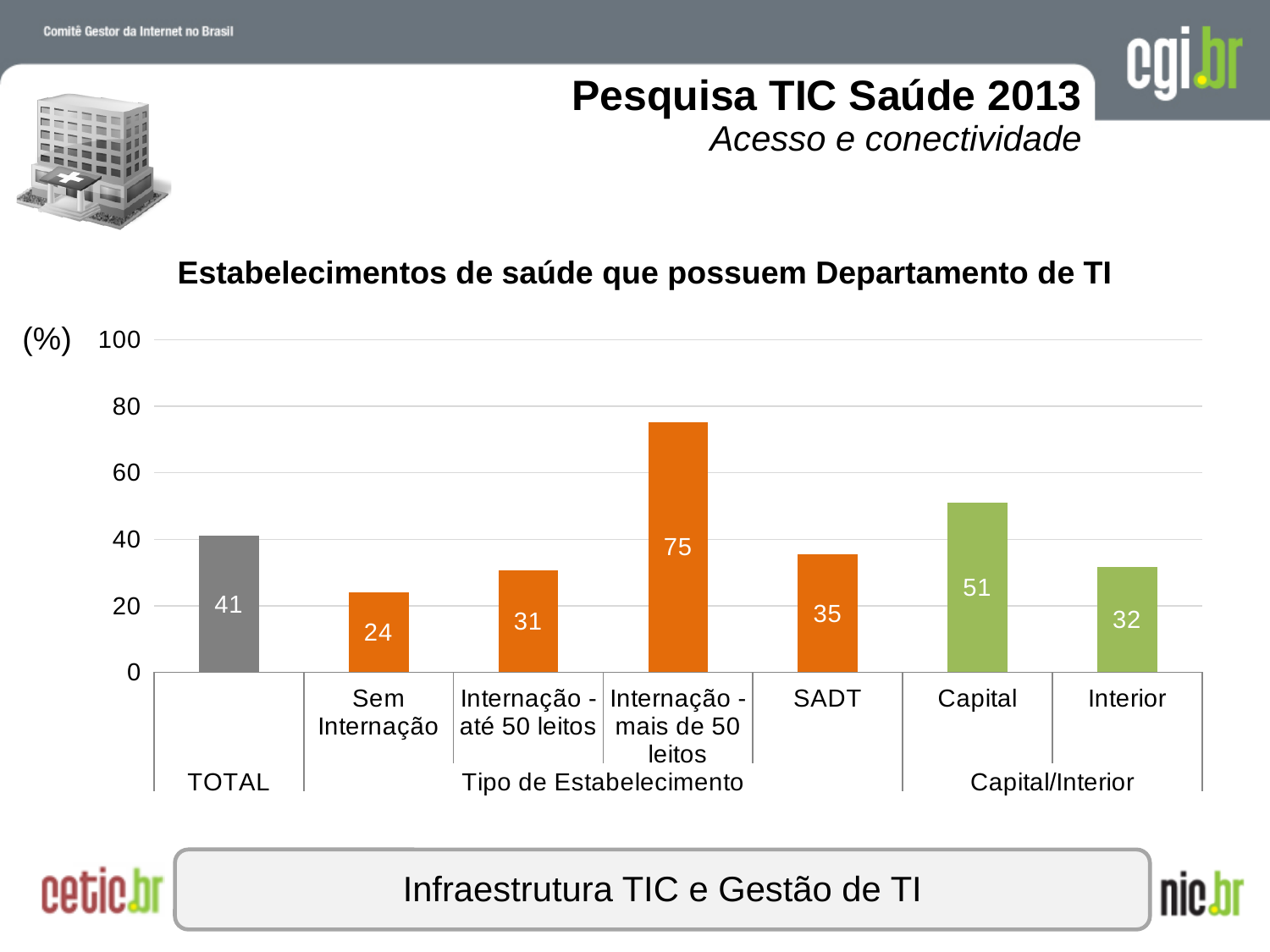
Which category has the lowest value? Sem Internação Is the value for Internação - mais de 50 leitos greater or less than 60? greater What is the value for SADT? 35 What is the value for Capital? 51 What is the value for TOTAL? 41 Which is larger, the value for Internação - até 50 leitos or the value for SADT? SADT What is the difference between the values for Capital and Interior? 19 What kind of chart is shown on the slide? bar chart What is the value for Internação - mais de 50 leitos? 75 What is the title of the chart? Estabelecimentos de saúde que possuem Departamento de TI Which category has the highest value? Internação - mais de 50 leitos How many bars are shown in the chart? 7